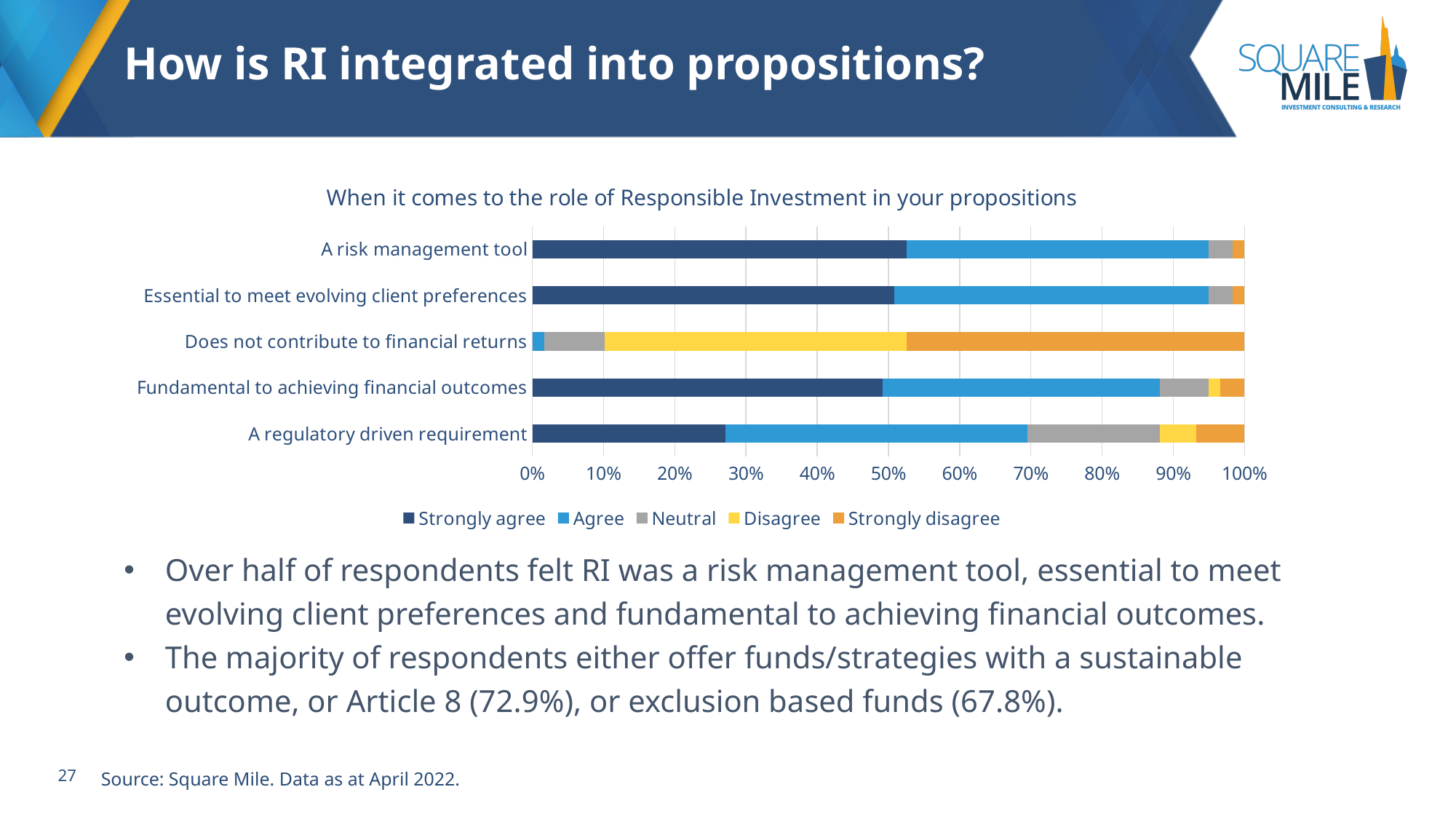
Which has the larger 'Strongly agree' share: 'A risk management tool' or 'A regulatory driven requirement'? A risk management tool Is the 'Strongly agree' share for 'A regulatory driven requirement' greater or less than 30%? less How many categories (statements) are plotted on the chart? 5 How many series does the chart legend list? 5 Is the 'Strongly agree' share for 'Fundamental to achieving financial outcomes' greater or less than 40%? greater What is the title of the chart? When it comes to the role of Responsible Investment in your propositions Which series is shown in orange in the chart legend? Strongly disagree Is the 'Strongly disagree' share for 'Does not contribute to financial returns' greater or less than 40%? greater Which statement has the largest 'Strongly disagree' share? Does not contribute to financial returns Which statement has the smallest 'Strongly agree' share? Does not contribute to financial returns What kind of chart is shown on the slide? Stacked bar chart